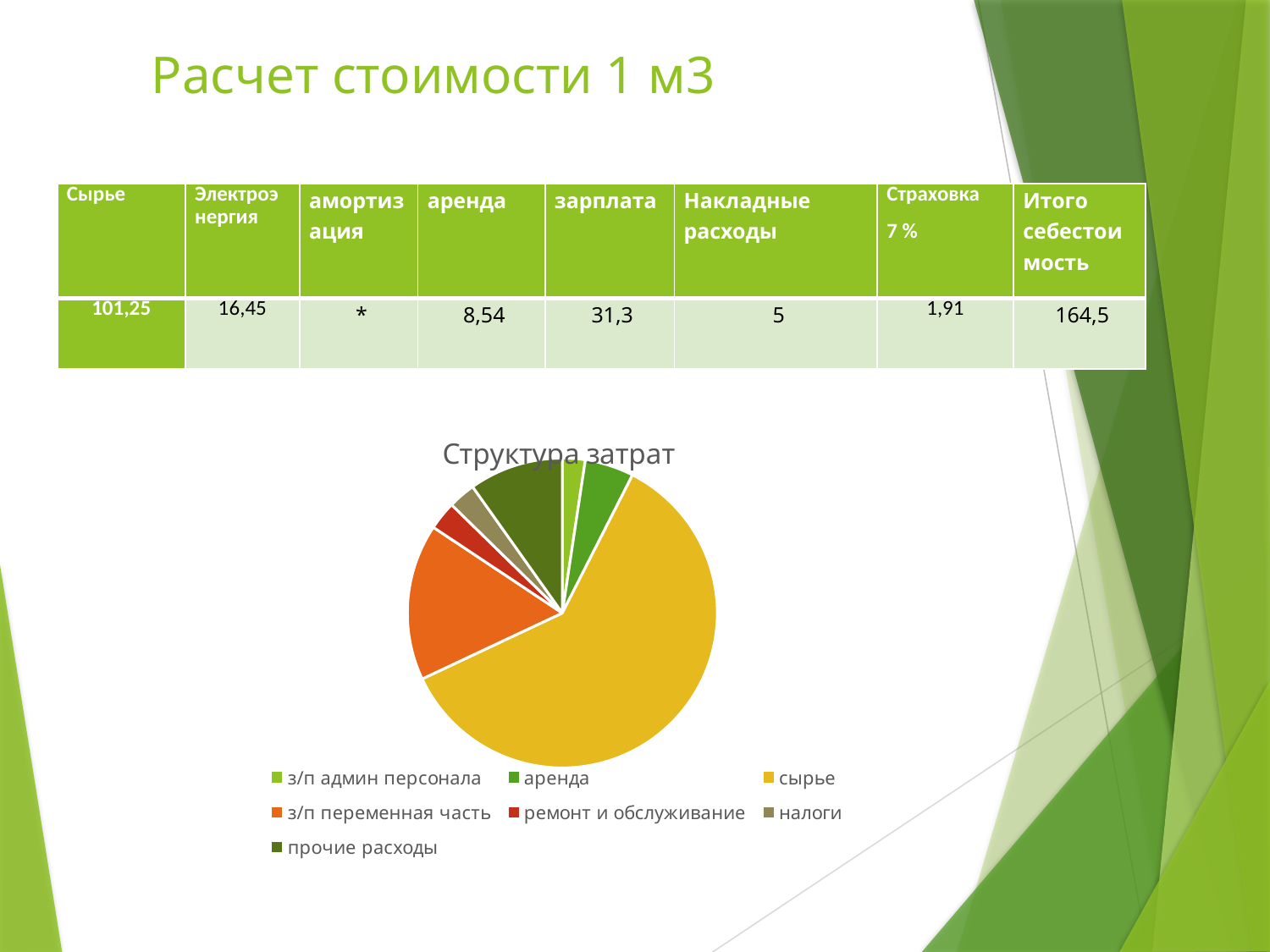
Which category has the largest slice in the pie chart? сырье Which category has the smallest slice in the pie chart? з/п админ персонала What colour is the сырье slice in the pie chart? yellow Which slice is larger in the pie chart, сырье or з/п переменная часть? сырье How many categories does the legend of the pie chart list? 7 Which slice is larger in the pie chart, з/п переменная часть or аренда? з/п переменная часть Which category is the second-largest slice in the pie chart? з/п переменная часть Which slice is larger in the pie chart, прочие расходы or налоги? прочие расходы What is the title of the chart on the slide? Структура затрат What kind of chart is shown on the slide? pie chart